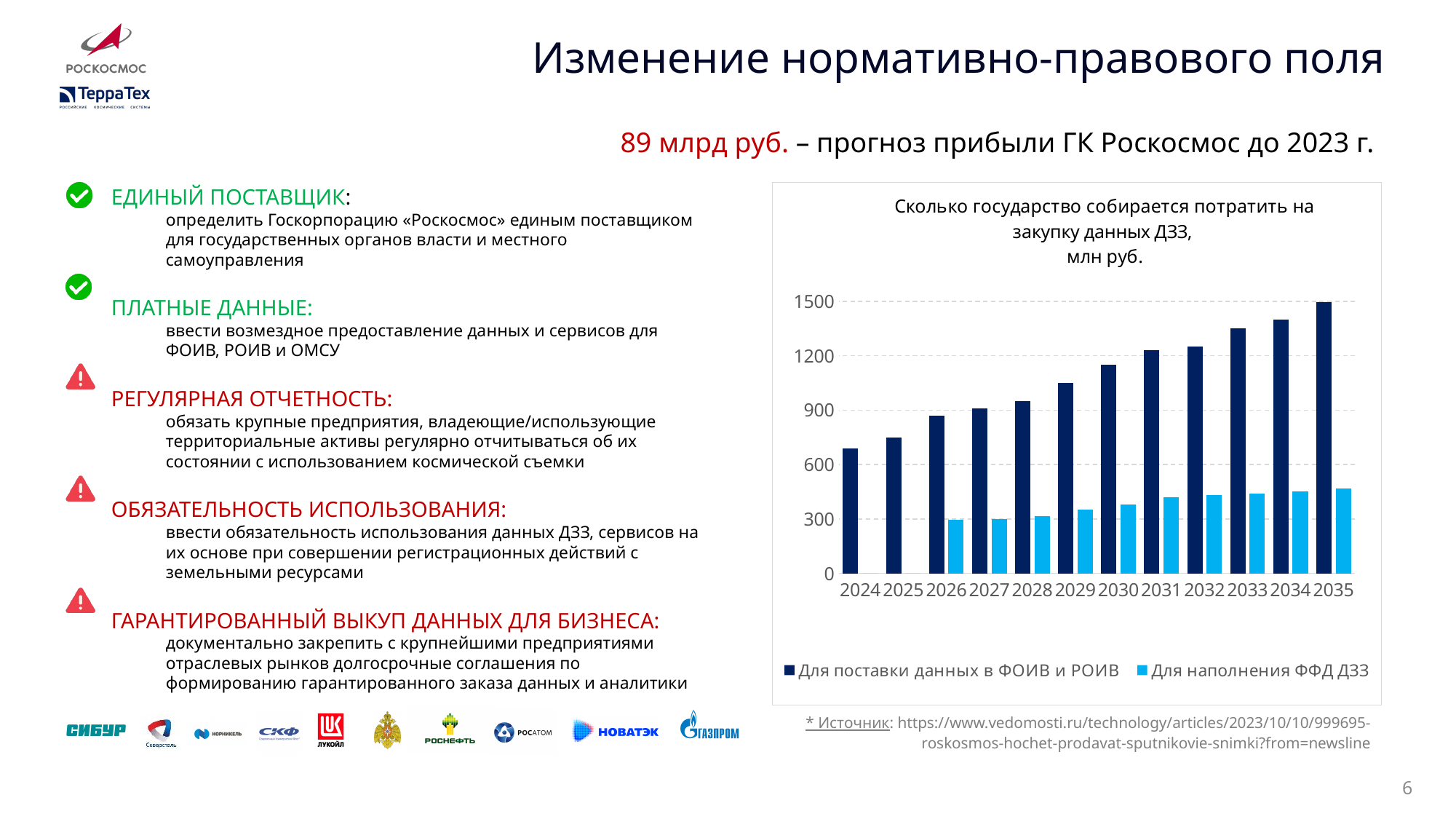
How many years are shown on the x axis of the chart? 12 Do the values for 'Для поставки данных в ФОИВ и РОИВ' rise or fall from 2024 to 2035? rise How many series does the chart legend list? 2 Is the value for 'Для поставки данных в ФОИВ и РОИВ' in 2024 greater or less than 600? greater Which year has the lowest value for 'Для поставки данных в ФОИВ и РОИВ'? 2024 Which series is shown in light blue in the chart? Для наполнения ФФД ДЗЗ What kind of chart is shown on the slide? bar chart What unit is stated in the chart title? млн руб. Is the value for 'Для наполнения ФФД ДЗЗ' in 2035 greater or less than 300? greater Is the value for 'Для поставки данных в ФОИВ и РОИВ' in 2034 greater or less than 1200? greater Which year has the highest value for 'Для поставки данных в ФОИВ и РОИВ'? 2035 In 2030, which series has the larger value: 'Для поставки данных в ФОИВ и РОИВ' or 'Для наполнения ФФД ДЗЗ'? Для поставки данных в ФОИВ и РОИВ